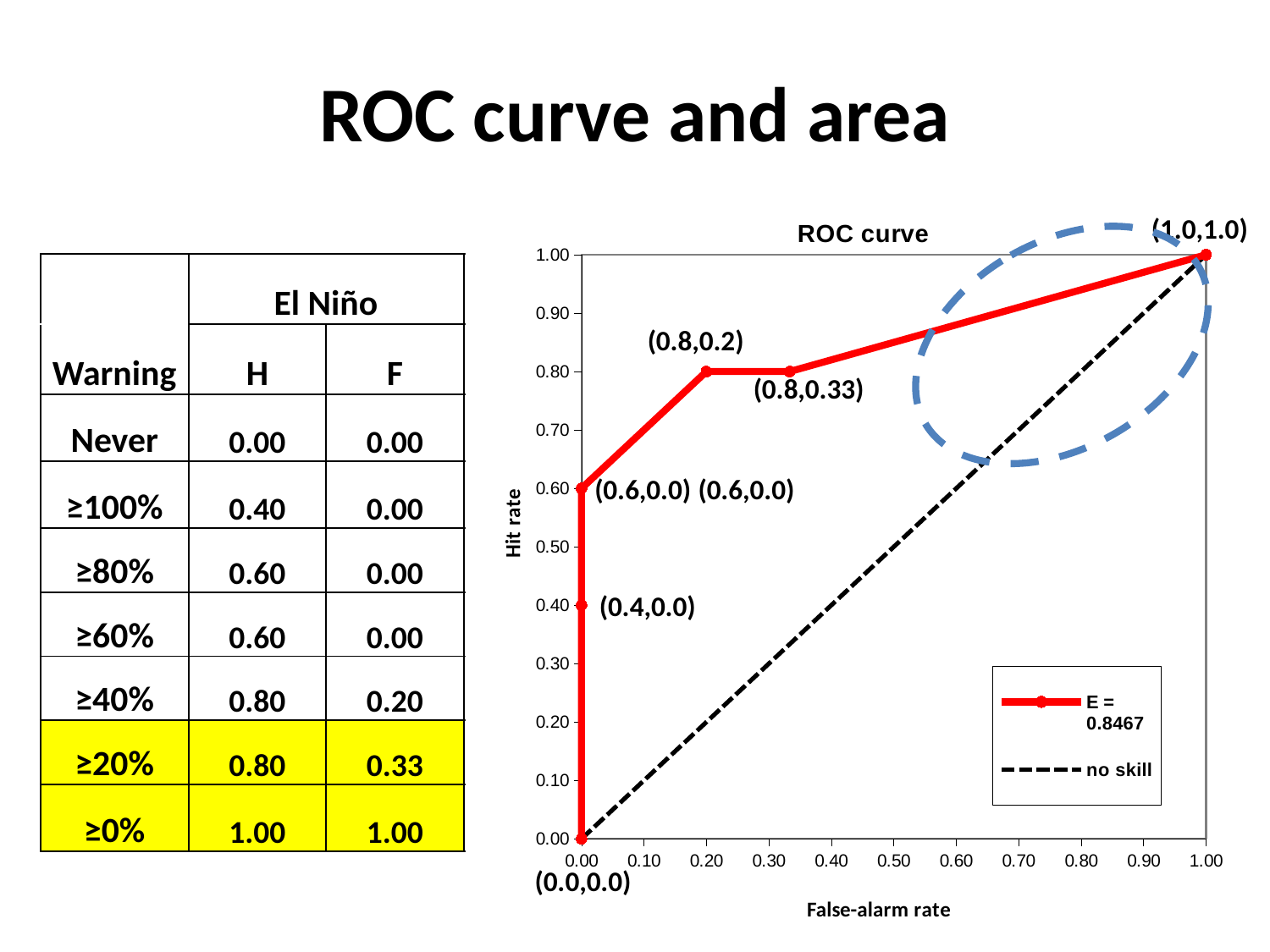
How many series does the legend of the ROC curve chart list? 2 What is the title of the chart on the slide? ROC curve What kind of chart is the ROC curve chart? line chart In the ROC curve chart, what is the hit rate of the point labeled (0.4,0.0)? 0.4 In the ROC curve chart, does the hit rate of the red curve rise or fall as the false-alarm rate increases? rises In the ROC curve chart, is the hit rate of the point labeled (0.8,0.33) greater or less than 0.70? greater In the ROC curve chart, what is the hit rate of the point labeled (0.8,0.33)? 0.8 What are the two legend entries in the ROC curve chart? E = 0.8467 and no skill In the ROC curve chart, which labeled point has the highest hit rate? (1.0,1.0) In the ROC curve chart, what is the hit rate at a false-alarm rate of 0.20? 0.80 In the ROC curve chart, at a false-alarm rate of 0.20, which line is higher: E = 0.8467 or no skill? E = 0.8467